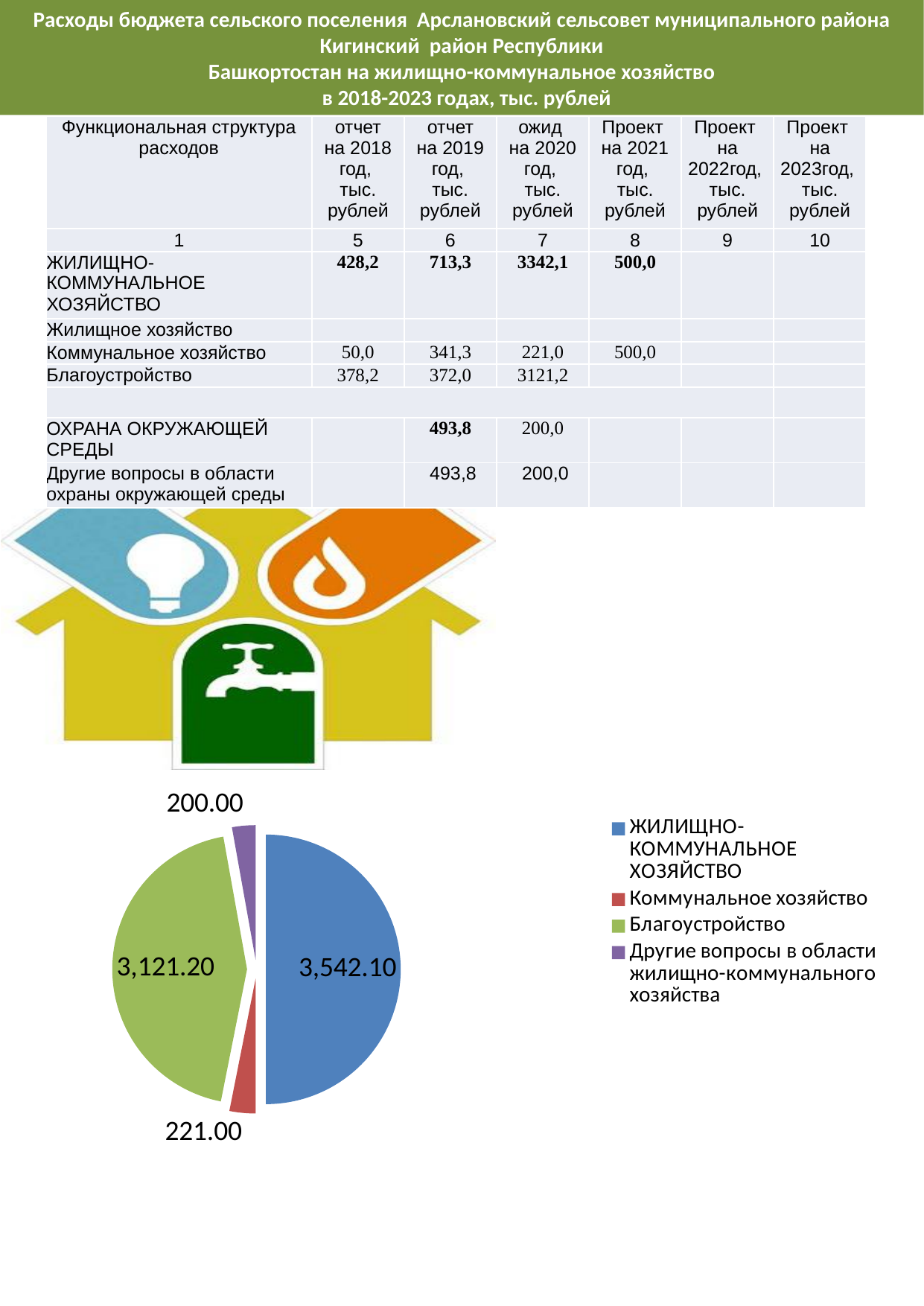
In the pie chart, what is the value for Другие вопросы в области жилищно-коммунального хозяйства? 200.00 In the pie chart, what is the value for ЖИЛИЩНО-КОММУНАЛЬНОЕ ХОЗЯЙСТВО? 3,542.10 In the pie chart, what is the value for Благоустройство? 3,121.20 Which slice of the pie chart has the largest value? ЖИЛИЩНО-КОММУНАЛЬНОЕ ХОЗЯЙСТВО What colour is the Благоустройство slice in the pie chart? green Which slice of the pie chart has the smallest value? Другие вопросы в области жилищно-коммунального хозяйства In the pie chart, what is the difference between the values for Коммунальное хозяйство and Другие вопросы в области жилищно-коммунального хозяйства? 21.00 How many slices does the pie chart have? 4 In the pie chart, which is larger: Благоустройство or Коммунальное хозяйство? Благоустройство In the pie chart, what is the difference between the values for ЖИЛИЩНО-КОММУНАЛЬНОЕ ХОЗЯЙСТВО and Благоустройство? 420.90 What type of chart is shown at the bottom of the slide? pie chart In the pie chart, what is the value for Коммунальное хозяйство? 221.00